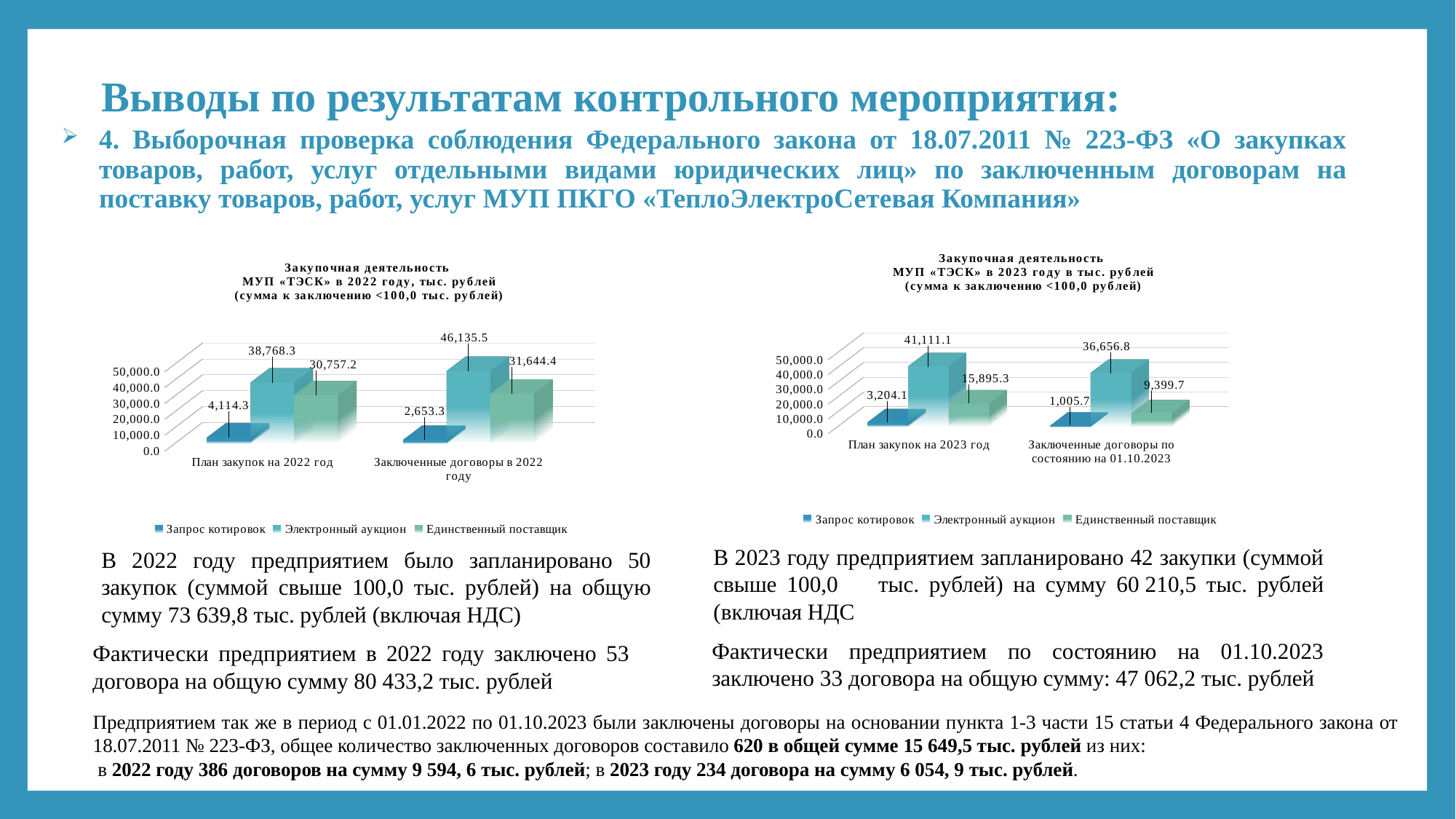
In the right chart (2023), which is larger: Запрос котировок for План закупок на 2023 год or Запрос котировок for Заключенные договоры по состоянию на 01.10.2023? План закупок на 2023 год How many categories are shown on the x axis of the right chart (2023)? 2 In the right chart (2023), what is the value for Электронный аукцион in the Заключенные договоры по состоянию на 01.10.2023 category? 36,656.8 In the right chart (2023), what is the difference between the Единственный поставщик values for План закупок на 2023 год and Заключенные договоры по состоянию на 01.10.2023? 6,495.6 In the right chart (2023), what is the value for Единственный поставщик in the План закупок на 2023 год category? 15,895.3 How many series does the legend of the left chart (2022) list? 3 In the left chart (2022), what is the value for Электронный аукцион in the План закупок на 2022 год category? 38,768.3 In the left chart (2022), what is the value for Запрос котировок in the Заключенные договоры в 2022 году category? 2,653.3 In the left chart (2022), what is the difference between the Электронный аукцион values for Заключенные договоры в 2022 году and План закупок на 2022 год? 7,367.2 In the right chart (2023), which series has the lowest value in the План закупок на 2023 год category? Запрос котировок What type of chart is the left chart (2022)? Bar chart In the left chart (2022), which series has the highest value in the Заключенные договоры в 2022 году category? Электронный аукцион